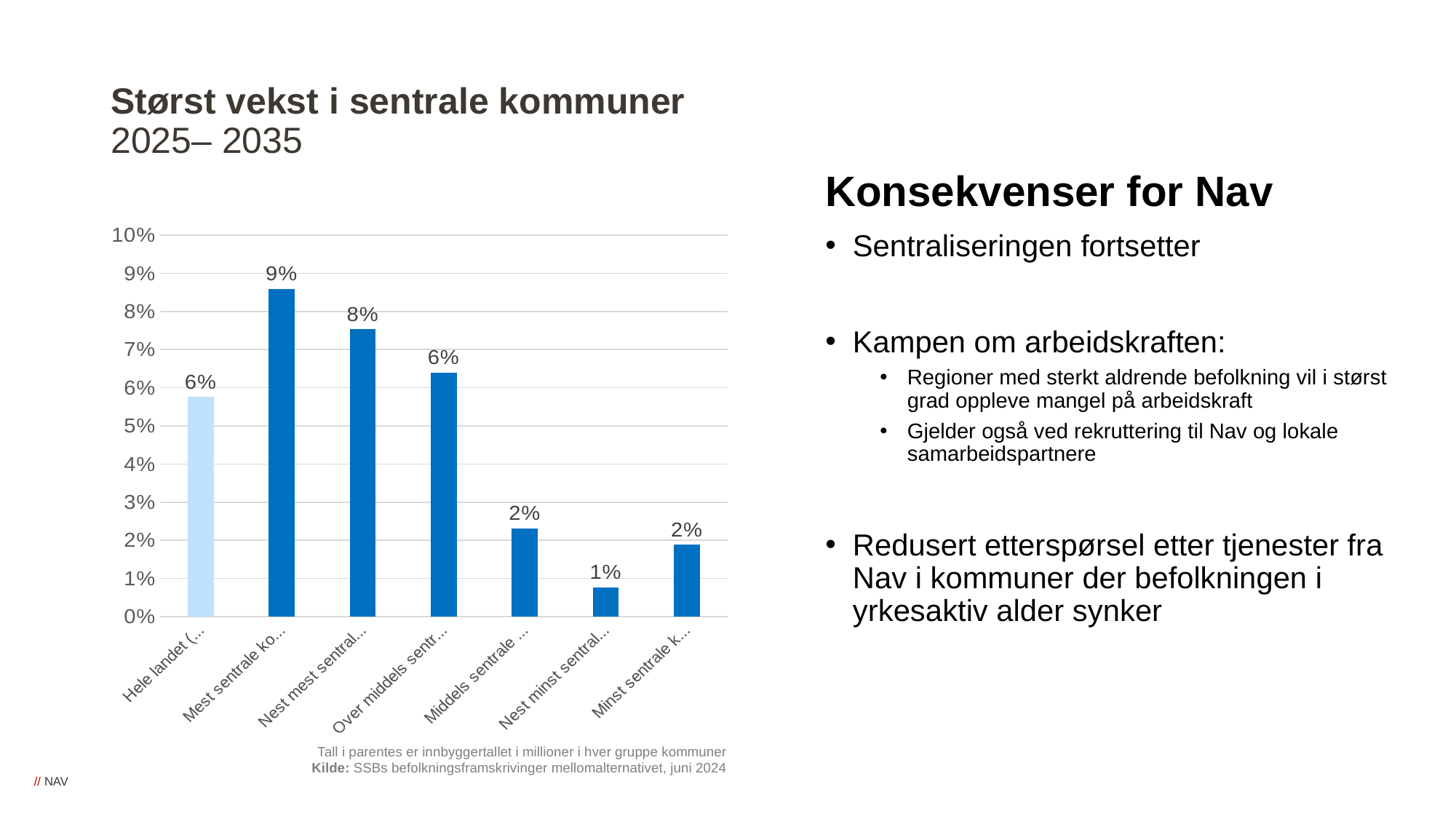
From "Mest sentrale" to "Nest minst sentral", do the values rise or fall? fall Is the value for "Hele landet" greater or less than 5%? greater Which category has the lowest value in the chart? Nest minst sentral What is the difference between the values for "Mest sentrale" and "Hele landet"? 3% What is the title of the chart? Størst vekst i sentrale kommuner 2025– 2035 What is the value for "Hele landet" in the chart? 6% Which is larger, the value for "Nest mest sentral" or the value for "Over middels sentr"? Nest mest sentral What is the value for "Nest minst sentral" kommuner in the chart? 1% What is the value for "Mest sentrale" kommuner in the chart? 9% What kind of chart is shown on the slide? bar chart Which category has the highest value in the chart? Mest sentrale How many categories are shown in the chart? 7